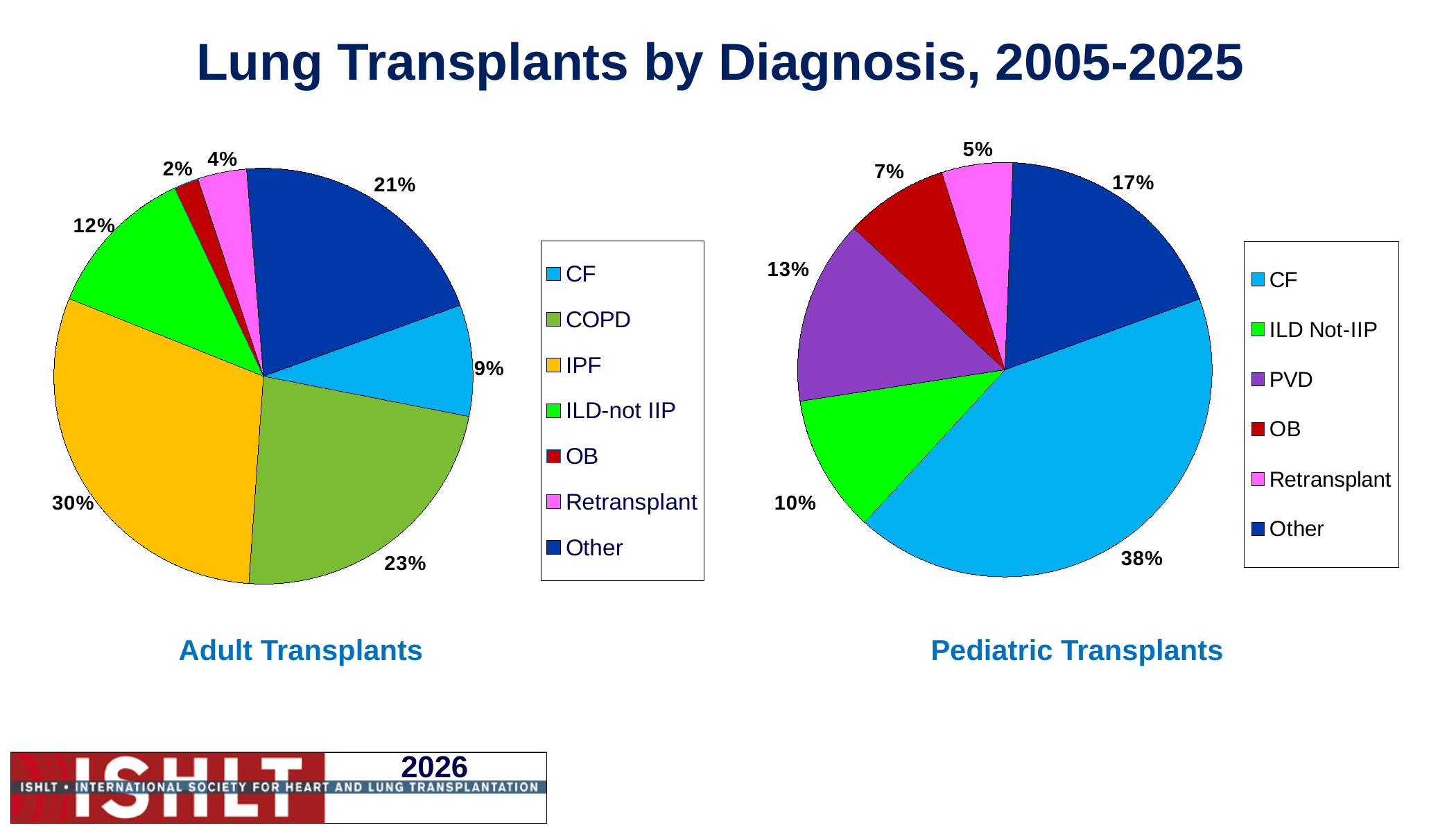
In the Pediatric Transplants pie chart, which diagnosis has the smallest share? Retransplant In the Adult Transplants pie chart, what share is COPD? 23% In the Pediatric Transplants pie chart, what share is CF? 38% In the Adult Transplants pie chart, which diagnosis has the largest share? IPF In the Adult Transplants pie chart, which is larger, the share for CF or the share for ILD-not IIP? ILD-not IIP How many entries does the legend of the Adult Transplants chart list? 7 In the Adult Transplants pie chart, which diagnosis has the smallest share? OB In the Pediatric Transplants pie chart, what share is PVD? 13% In the Adult Transplants pie chart, what share is IPF? 30% In the Pediatric Transplants pie chart, what is the difference between the CF share and the Other share? 21% What type of chart is used for the Adult Transplants data? Pie chart How many slices does the Pediatric Transplants pie chart have? 6